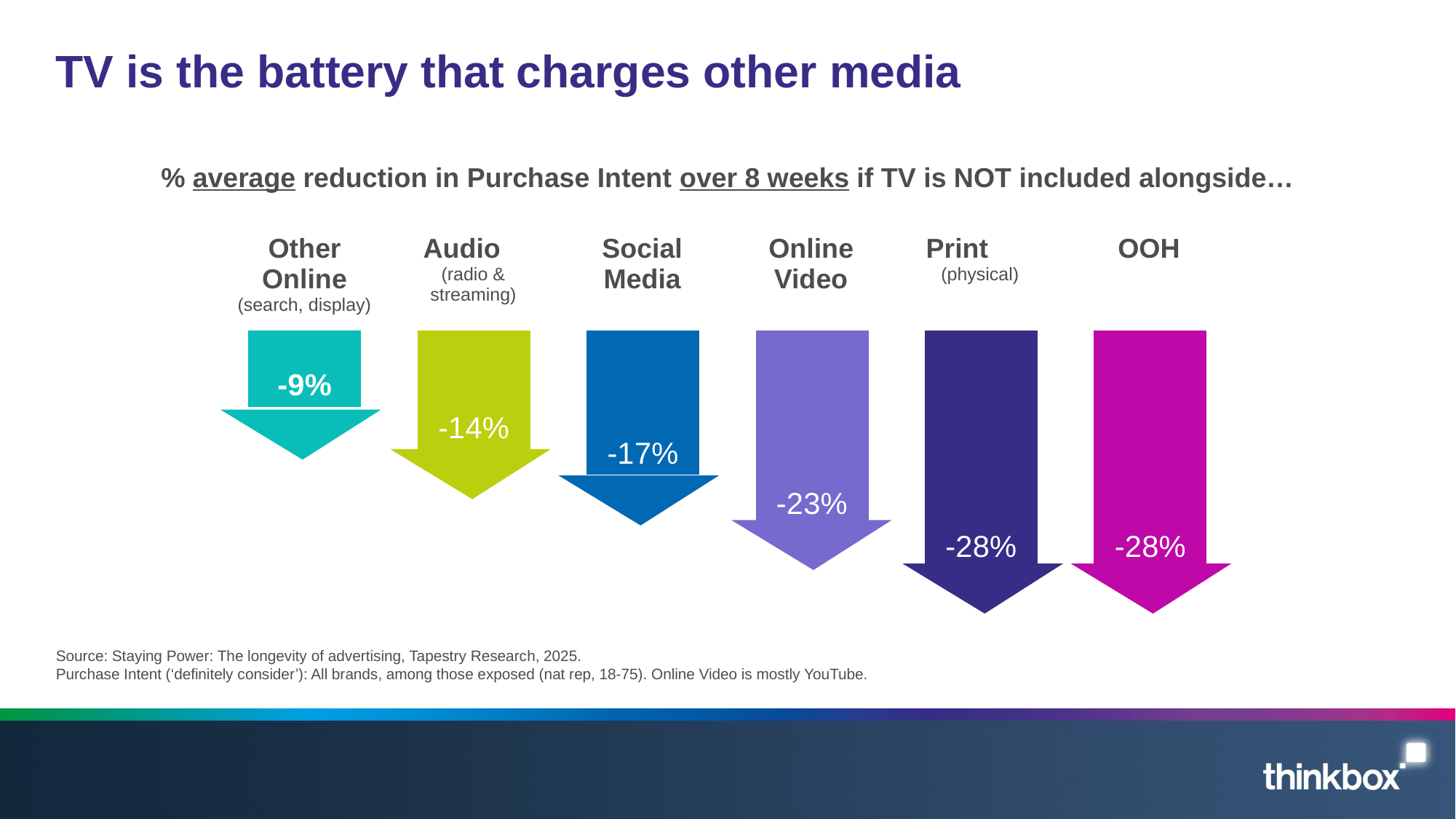
What is the average reduction in purchase intent shown for Other Online (search, display)? -9% Which category shows the smallest reduction in purchase intent? Other Online (search, display) What is the difference in percentage points between the reductions for Online Video and Other Online? 14 percentage points Which two categories share the same value of -28%? Print (physical) and OOH What reduction in purchase intent is shown for Online Video? -23% Do the reductions get larger or smaller moving from left to right across the chart? larger How many media categories are shown in the chart? 6 What value is shown for OOH? -28% What value is shown for Audio (radio & streaming)? -14% Which shows a larger reduction in purchase intent, Social Media or Audio? Social Media What shape is used to represent each value in the chart? Downward arrows What is the value shown for Social Media? -17%